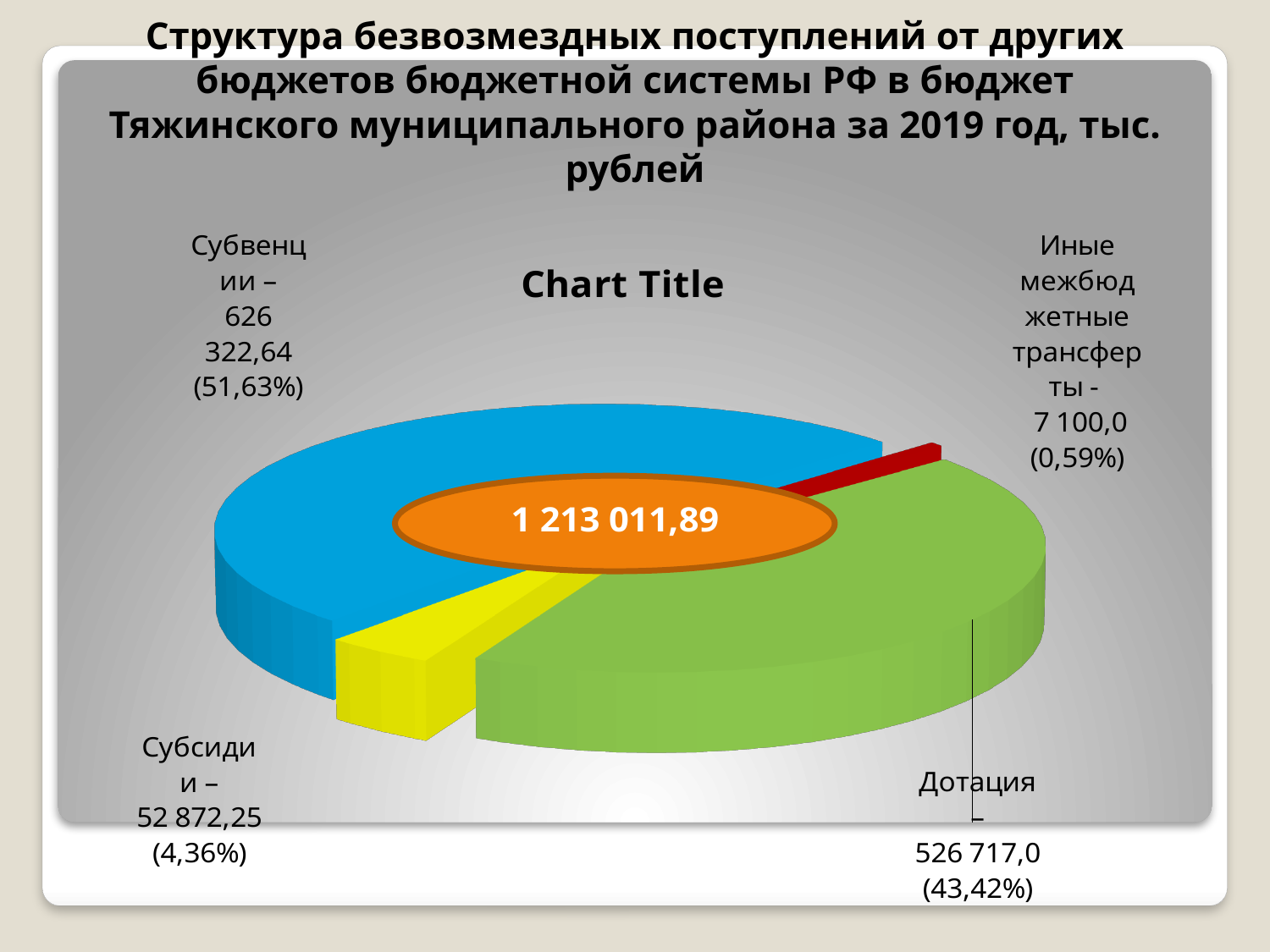
What share of the pie does Дотация represent? 43,42% What kind of chart is shown on the slide? Pie chart What is the value shown for Субсидии? 52 872,25 What is the value shown for Иные межбюджетные трансферты? 7 100,0 What is the value shown for Дотация? 526 717,0 What is the value shown for Субвенции? 626 322,64 What share of the pie does Субвенции represent? 51,63% Which category has the largest slice of the pie? Субвенции What total value is printed in the centre of the pie chart? 1 213 011,89 How many slices does the pie chart have? 4 Which is larger, the value for Субсидии or the value for Иные межбюджетные трансферты? Субсидии Which category has the smallest slice of the pie? Иные межбюджетные трансферты